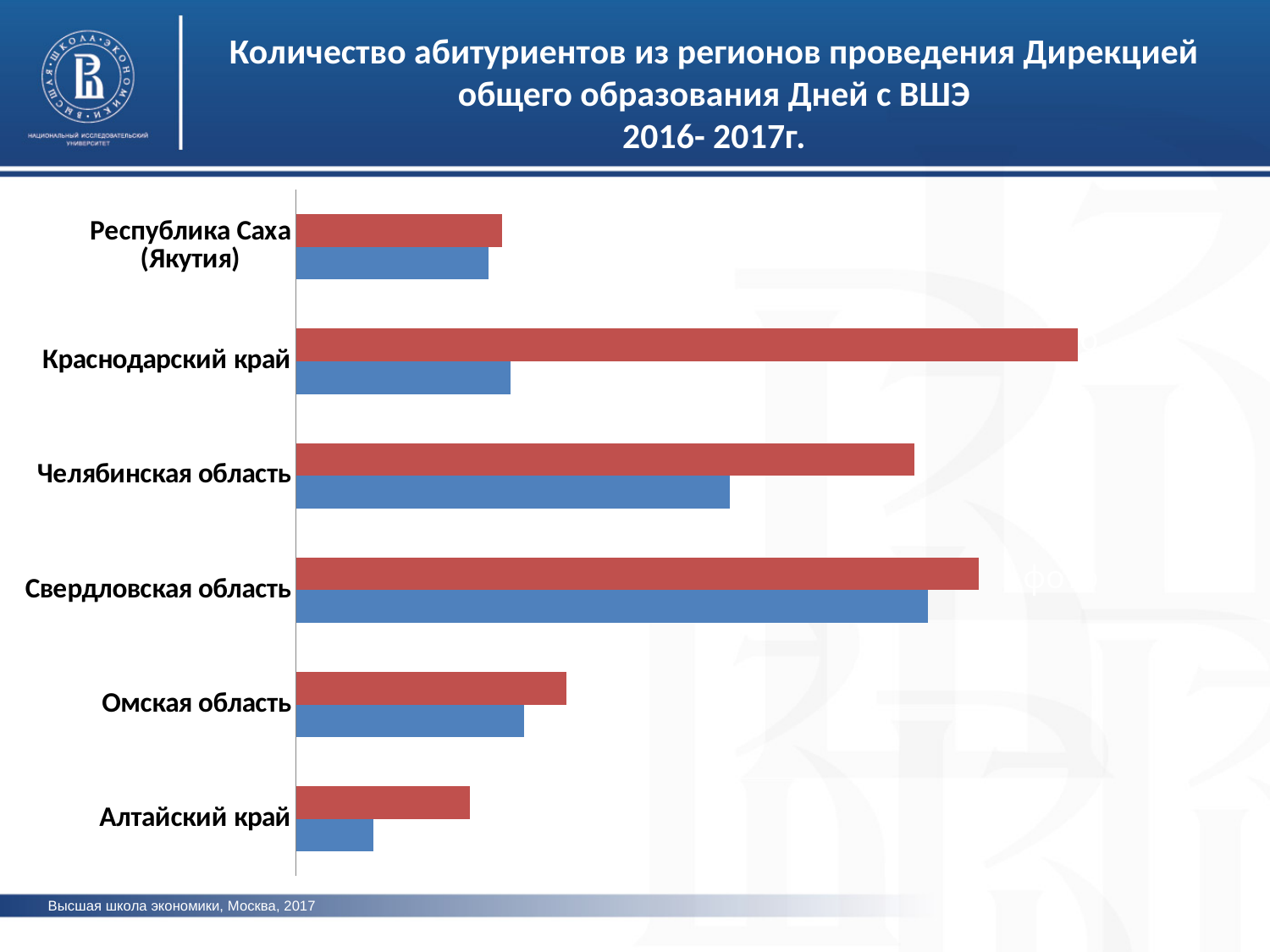
How many regions are listed on the chart? 6 For Краснодарский край, which bar is longer, the red one or the blue one? Red Which region has the longer red bar, Краснодарский край or Свердловская область? Краснодарский край For Челябинская область, which bar is longer, the red one or the blue one? Red Which region has the longest blue bar? Свердловская область Which region has the longest red bar? Краснодарский край Which region has the shortest red bar? Алтайский край Which region has the shortest blue bar? Алтайский край How many bars are shown for each region? 2 What kind of chart is shown on the slide? Bar chart Which years are mentioned in the chart title? 2016-2017